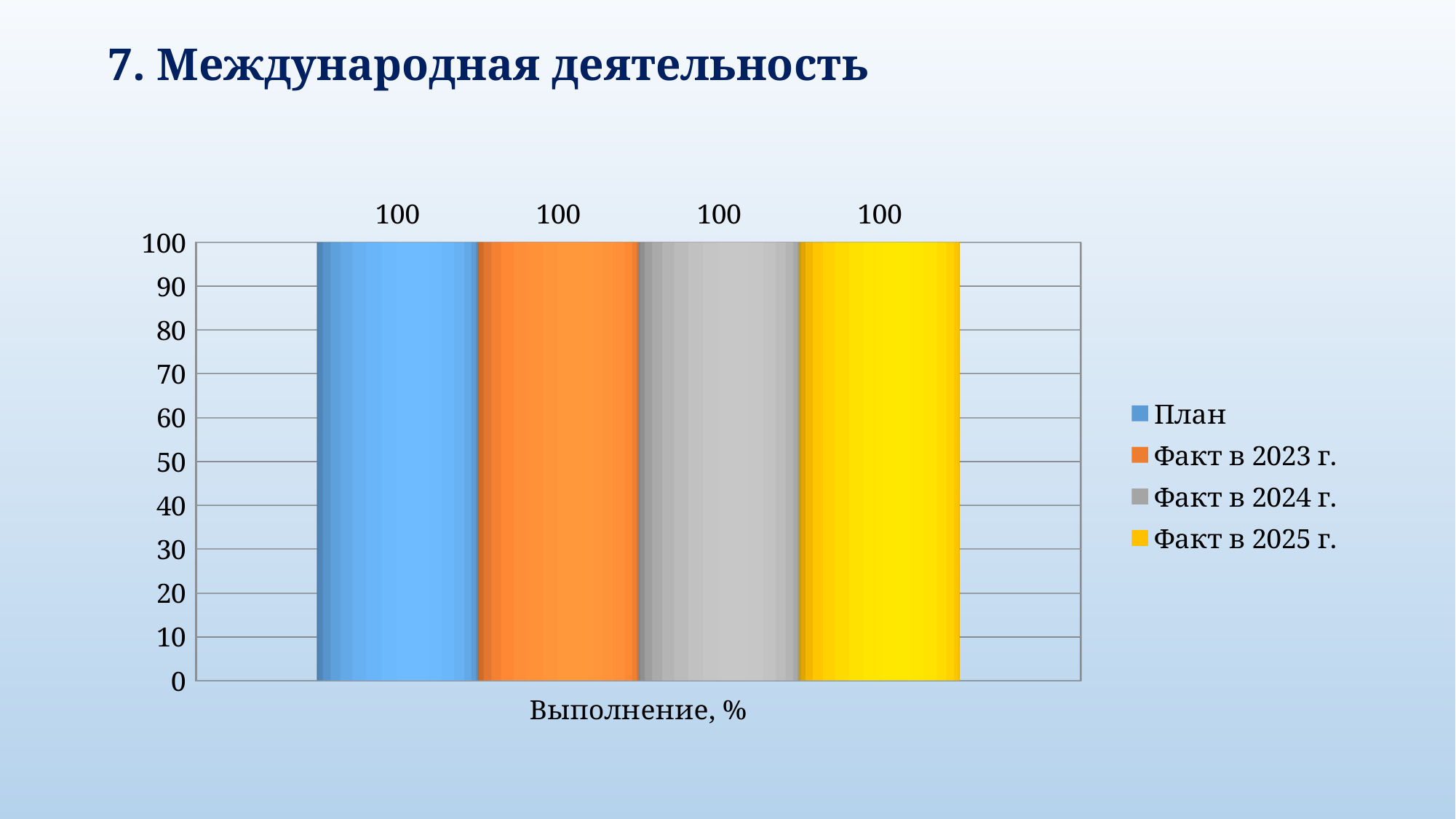
What is the value of the Факт в 2025 г. series? 100 How many series does the legend list? 4 What is the value of the Факт в 2024 г. series? 100 What is the value of the Факт в 2023 г. series? 100 Is the value for Факт в 2024 г. greater or less than 50? greater Which colour represents the Факт в 2025 г. series in the legend? yellow What is the label of the category on the x axis? Выполнение, % What is the difference between the План value and the Факт в 2025 г. value? 0 How many categories are shown on the x axis? 1 What is the value of the План series in the chart? 100 What kind of chart is shown on the slide? bar chart